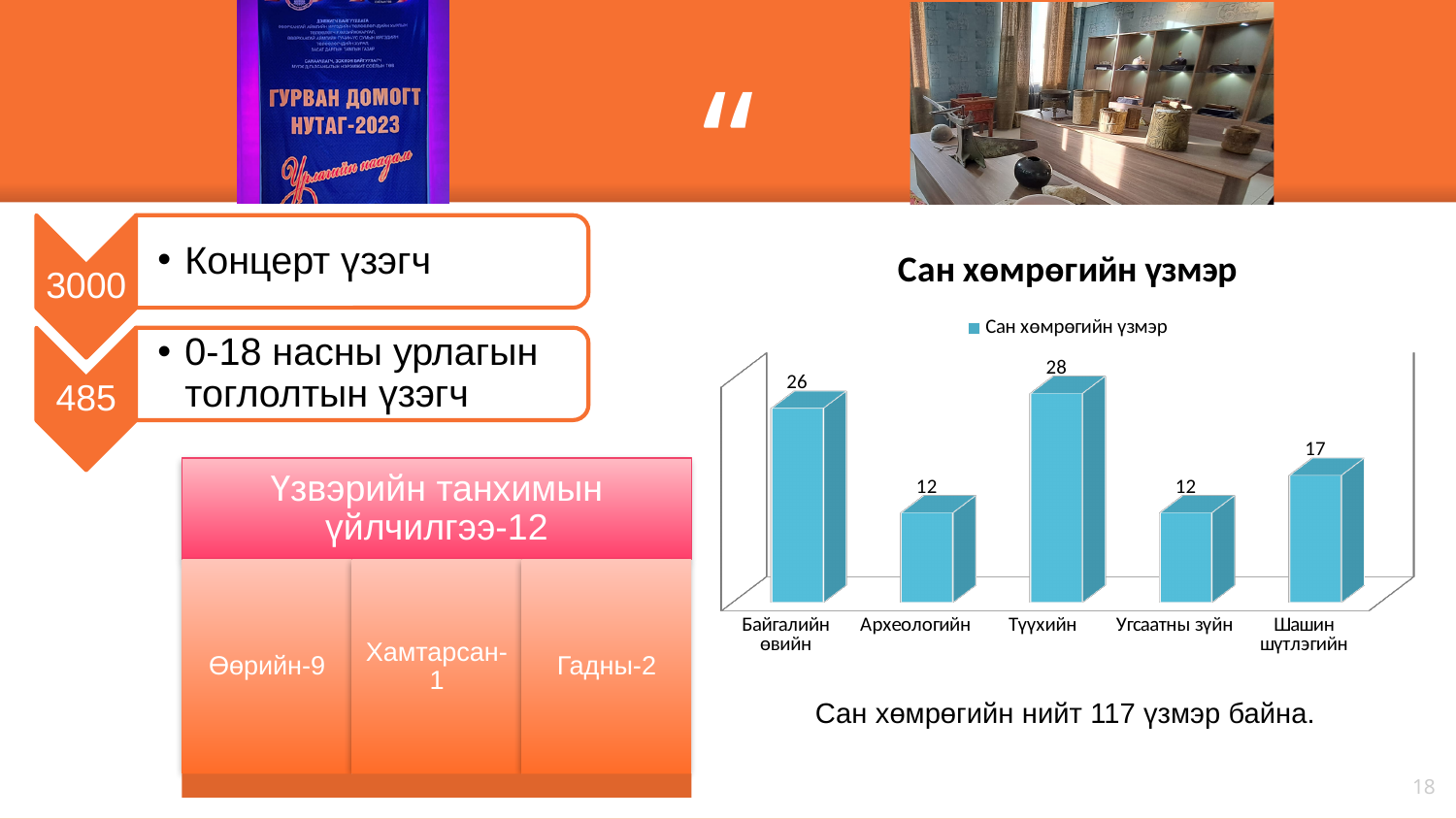
What is the value for Археологийн in the chart? 12 Which category has the highest value in the chart? Түүхийн How many categories are shown in the chart? 5 What is the value for Түүхийн in the chart? 28 How many series does the chart legend list? 1 What is the difference between the values for Түүхийн and Байгалийн өвийн? 2 What kind of chart is shown on the slide? bar chart What is the value for Байгалийн өвийн in the chart? 26 Which is larger, the value for Шашин шүтлэгийн or the value for Угсаатны зүйн? Шашин шүтлэгийн What is the difference between the values for Байгалийн өвийн and Шашин шүтлэгийн? 9 What is the value for Шашин шүтлэгийн in the chart? 17 What is the title of the chart? Сан хөмрөгийн үзмэр